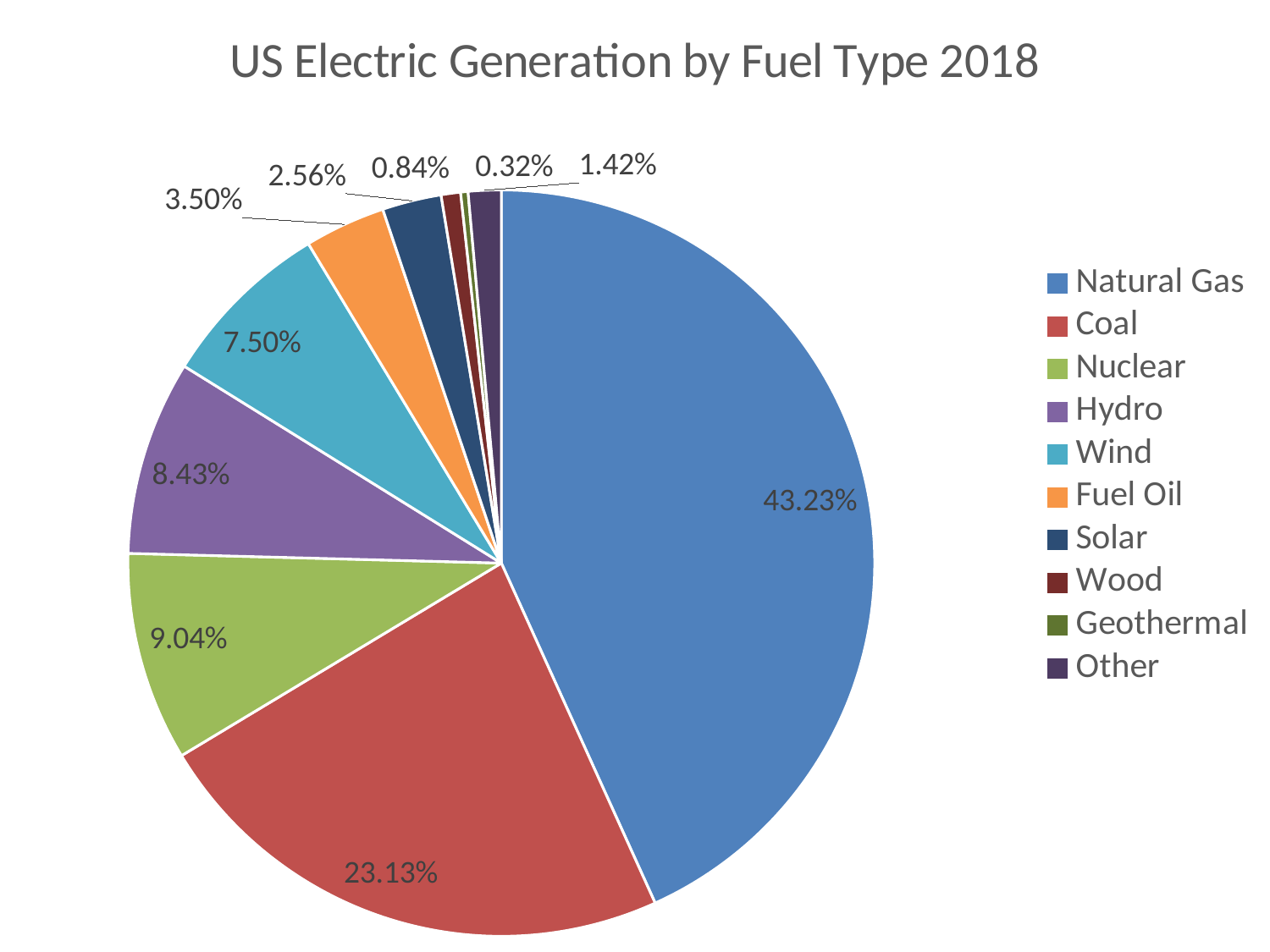
What is the title of the chart? US Electric Generation by Fuel Type 2018 What is the value shown for Solar? 2.56% What is the difference between the Natural Gas and Coal shares? 20.10% What is the value shown for Wind? 7.50% Which fuel type has the smallest slice of the pie? Geothermal Which fuel type has the largest slice of the pie? Natural Gas What is the value shown for Coal? 23.13% What is the value shown for Nuclear? 9.04% How many fuel types does the legend list? 10 What kind of chart is shown on the slide? Pie chart What share of US electric generation in 2018 does Natural Gas account for? 43.23% Which is larger, the share for Hydro or the share for Wind? Hydro